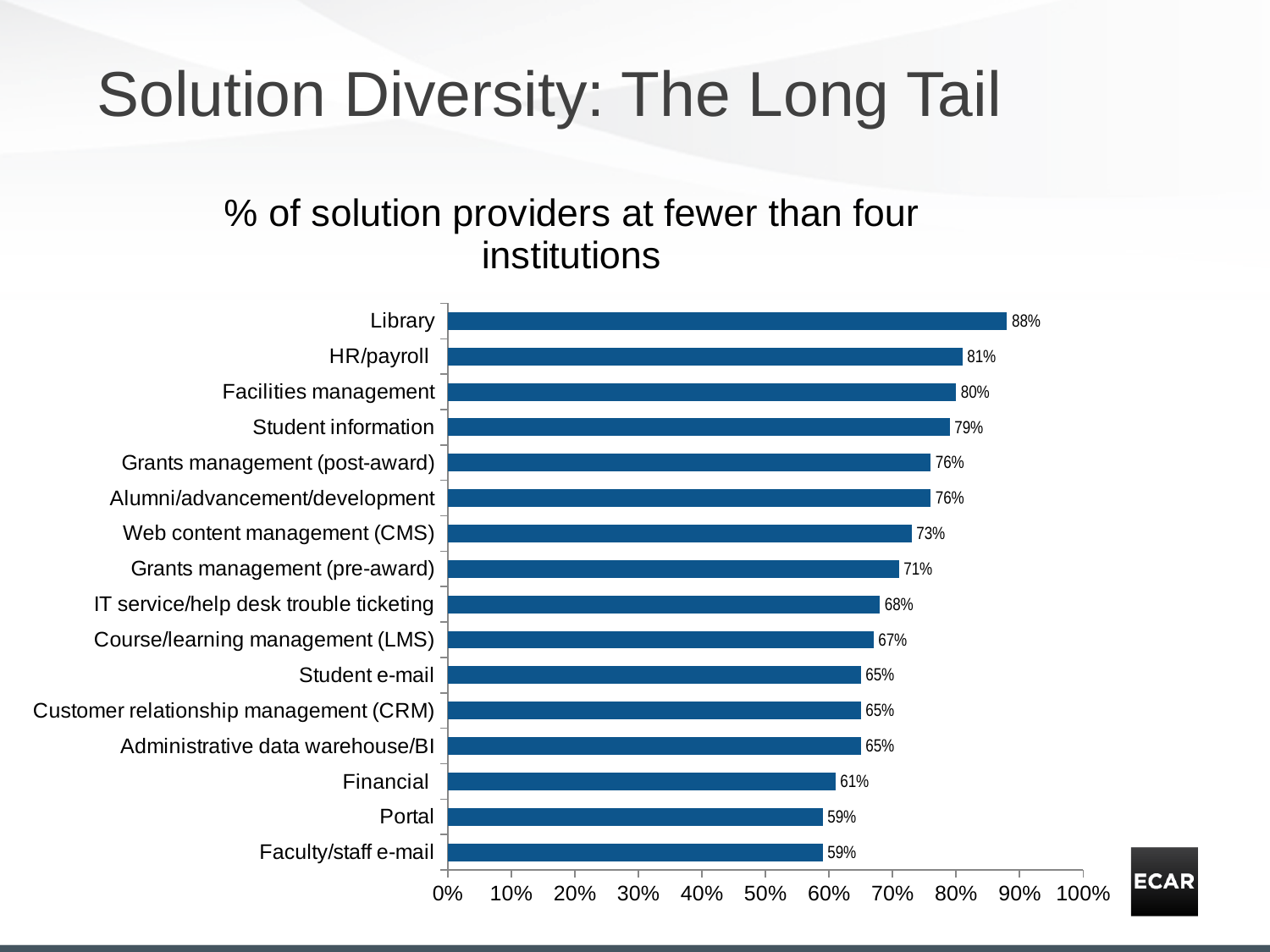
How many categories are shown in the chart? 16 What is the difference between the values for Library and HR/payroll? 7% Which is larger, the value for Web content management (CMS) or the value for Student e-mail? Web content management (CMS) What is the value for Library? 88% Which category has the highest value? Library What kind of chart is shown on the slide? Bar chart What is the value for Course/learning management (LMS)? 67% What is the difference between the values for Student information and Portal? 20% What is the value for Financial? 61% What is the title of the chart? % of solution providers at fewer than four institutions Is the value for Grants management (pre-award) greater or less than 60%? greater What is the value for IT service/help desk trouble ticketing? 68%